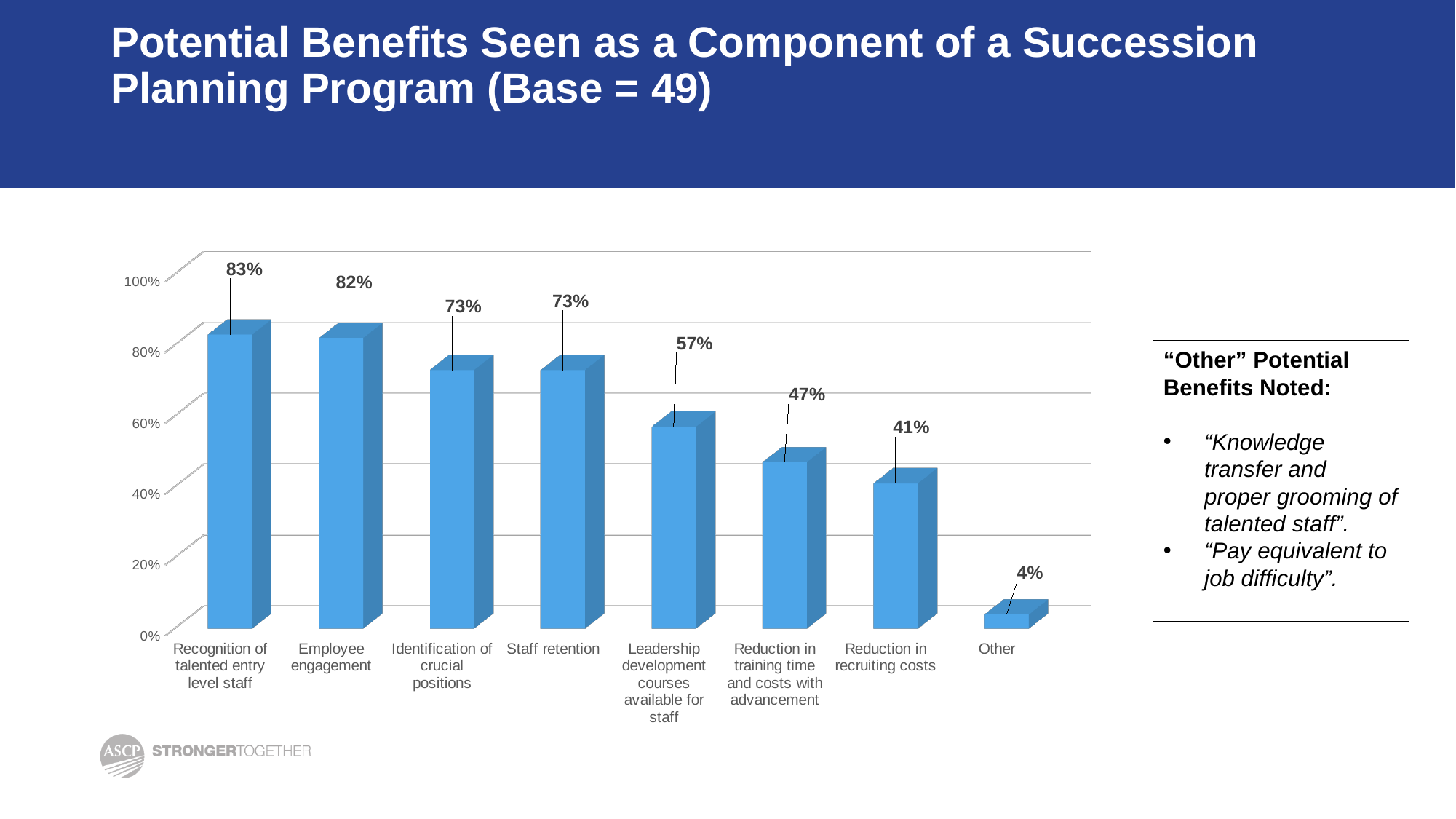
Do the values generally rise or fall moving from left to right along the x axis? Fall Which is larger: the value for identification of crucial positions or the value for leadership development courses available for staff? Identification of crucial positions What is the value shown for employee engagement? 82% Which category has the lowest value in the chart? Other What is the value shown for reduction in recruiting costs? 41% Is the value for reduction in training time and costs with advancement greater or less than 40%? greater What percentage of respondents saw recognition of talented entry level staff as a potential benefit? 83% How many categories are shown on the x axis of the chart? 8 Which category has the highest value in the chart? Recognition of talented entry level staff What kind of chart is shown on the slide? Bar chart What is the difference between the values for staff retention and reduction in training time and costs with advancement? 26% What is the value shown for leadership development courses available for staff? 57%